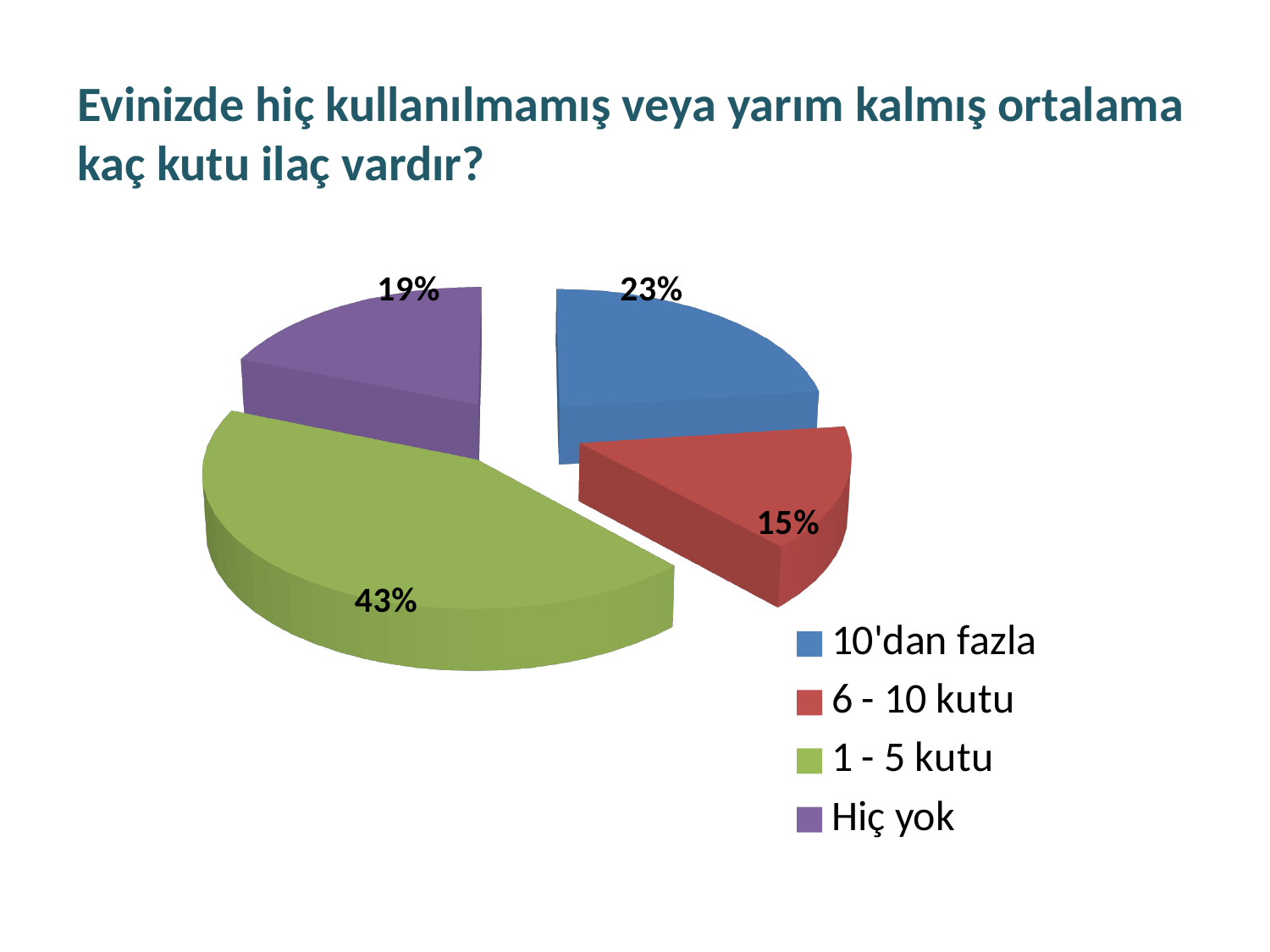
What is the difference between the 'Hiç yok' and '6 - 10 kutu' slices? 4% What kind of chart is shown on the slide? Pie chart What is the difference between the '1 - 5 kutu' and '10'dan fazla' slices? 20% What is the value shown for 'Hiç yok'? 19% What colour is the '1 - 5 kutu' slice? Green What is the value shown for '10'dan fazla'? 23% Which category has the smallest slice of the pie? 6 - 10 kutu What share of the pie does the '1 - 5 kutu' slice represent? 43% Which category has the largest slice of the pie? 1 - 5 kutu Which is larger, the '10'dan fazla' slice or the 'Hiç yok' slice? 10'dan fazla What is the value shown for '6 - 10 kutu'? 15% How many categories does the pie chart have? 4